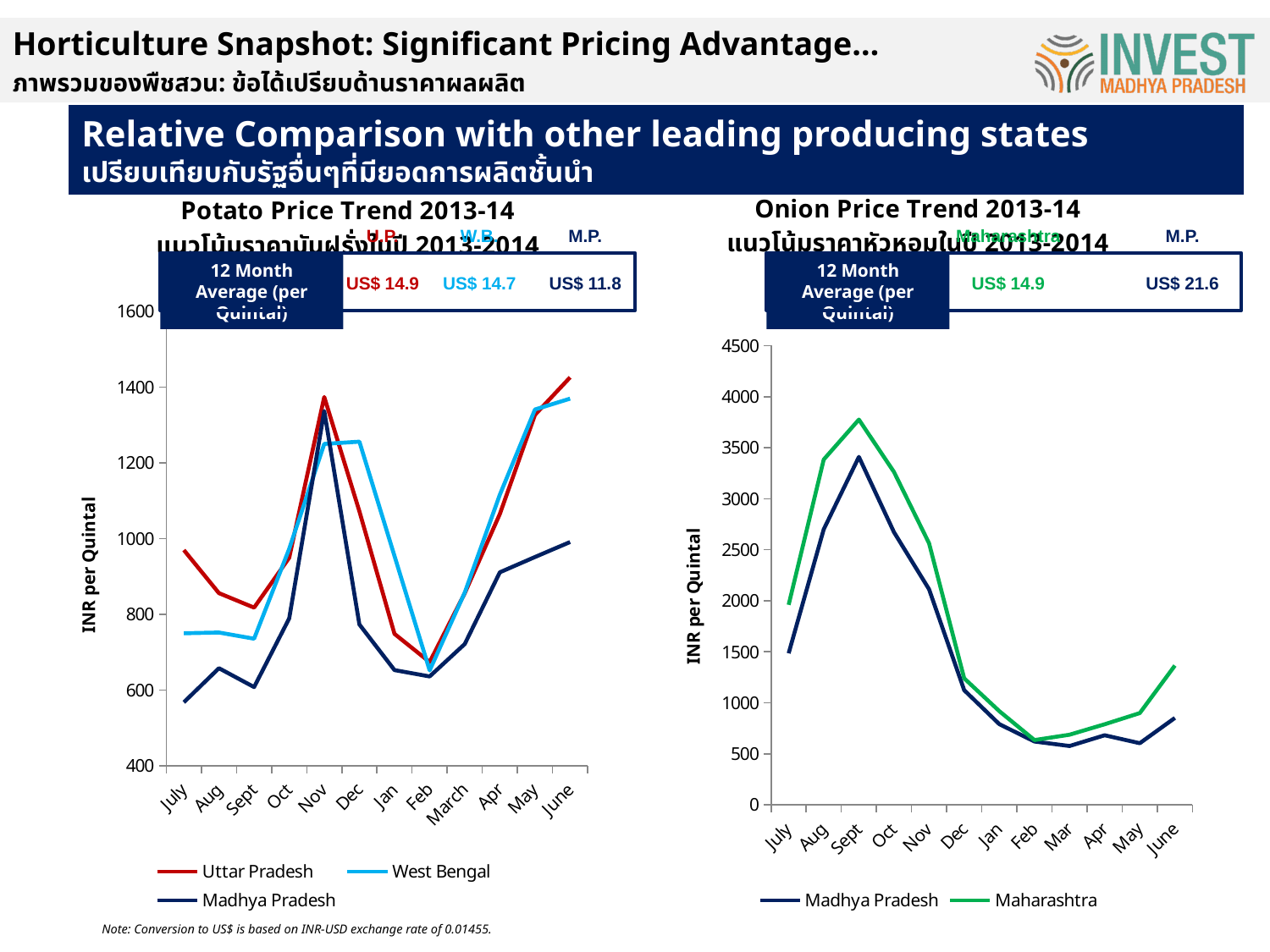
In the Potato Price Trend 2013-14 chart, which series has the higher value in Dec: West Bengal or Madhya Pradesh? West Bengal What type of chart is the Potato Price Trend 2013-14 chart? Line chart In the Onion Price Trend 2013-14 chart, is the value for Maharashtra in Sept greater or less than 3500? greater In the Potato Price Trend 2013-14 chart, is the value for West Bengal in Dec greater or less than 1200? greater In the Onion Price Trend 2013-14 chart, do Maharashtra's values rise or fall from Sept to Feb? fall How many series does the legend of the Onion Price Trend 2013-14 chart list? 2 How many months are plotted along the x axis of the Onion Price Trend 2013-14 chart? 12 In the Potato Price Trend 2013-14 chart, is the value for Madhya Pradesh in July greater or less than 600? less In the Onion Price Trend 2013-14 chart, what is the 12 month average (per quintal) shown for M.P.? US$ 21.6 How many series does the legend of the Potato Price Trend 2013-14 chart list? 3 In the Potato Price Trend 2013-14 chart, what is the 12 month average (per quintal) shown for M.P.? US$ 11.8 In the Onion Price Trend 2013-14 chart, which series has the higher value in Sept? Maharashtra